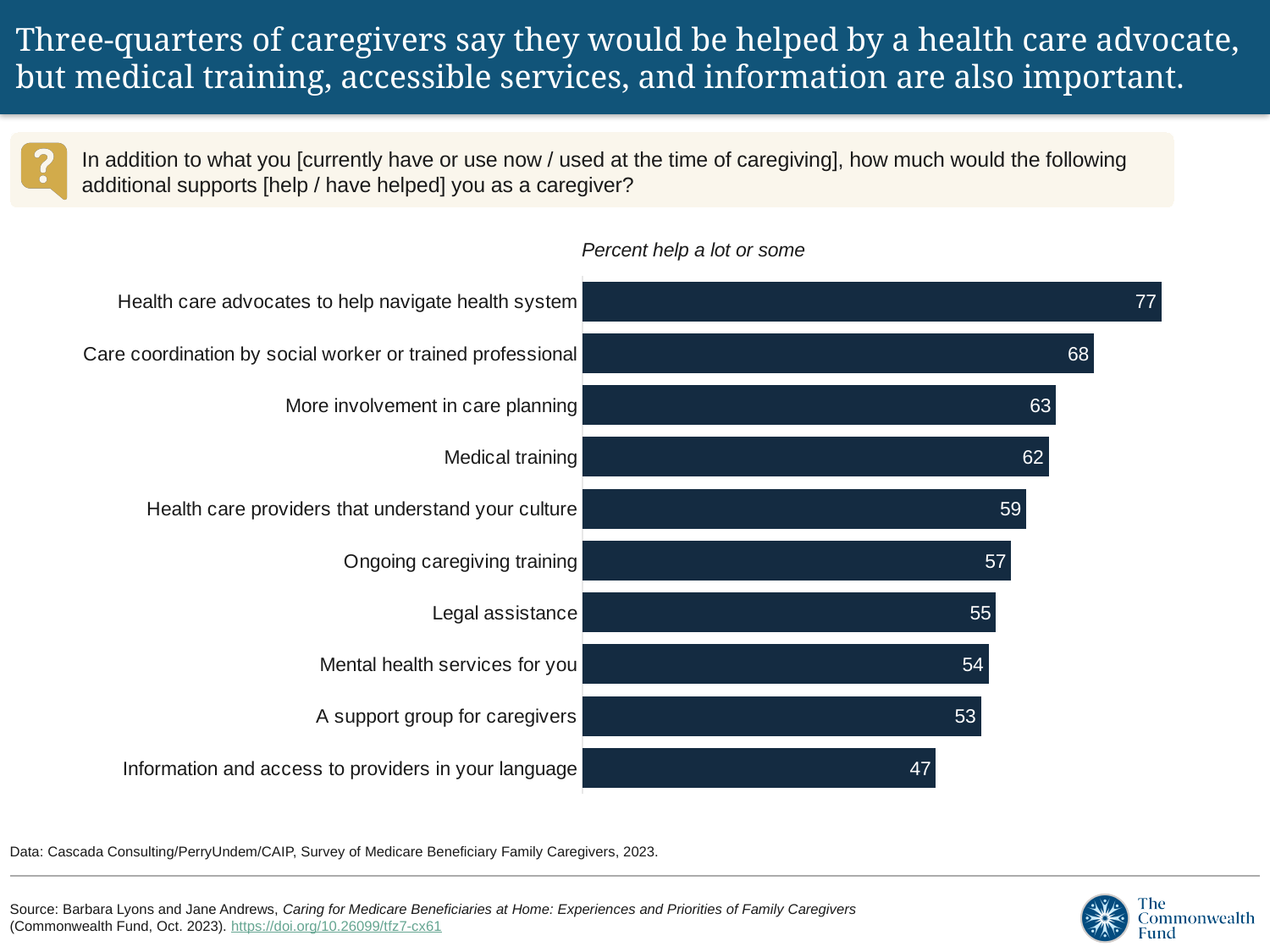
What is the difference between the values for health care advocates to help navigate health system and care coordination by social worker or trained professional? 9 Which support has the highest percent of caregivers saying it would help a lot or some? Health care advocates to help navigate health system What percent of caregivers say health care advocates to help navigate the health system would help a lot or some? 77 Which support has the lowest value on the chart? Information and access to providers in your language How many supports (categories) are shown on the chart? 10 What is the value shown for medical training? 62 What is the value shown for health care providers that understand your culture? 59 What kind of chart is shown on the slide? Bar chart Which is larger: the value for ongoing caregiving training or the value for mental health services for you? Ongoing caregiving training What is the difference between the values for legal assistance and information and access to providers in your language? 8 What is the value shown for a support group for caregivers? 53 What does the label above the chart say the values represent? Percent help a lot or some